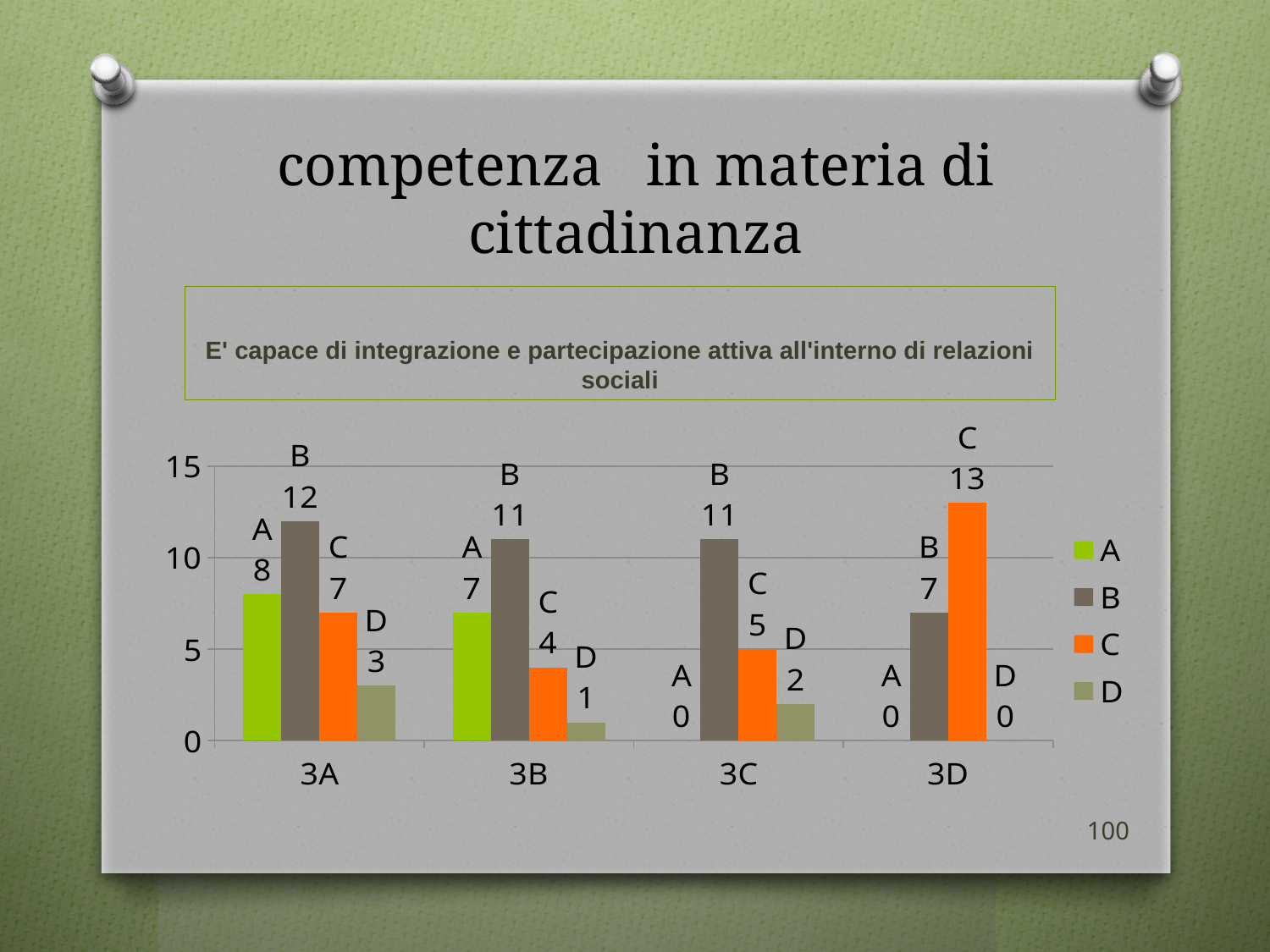
Which is larger for category 3C: series B or series C? B What is the value of series D for category 3B? 1 Which series has the lowest value for category 3A? D What kind of chart is shown on the slide? bar chart What is the difference between series B and series C for category 3B? 7 How many categories are shown on the x axis? 4 What colour represents series C in the legend? orange What is the value of series A for category 3C? 0 What is the value of series B for category 3A? 12 How many series does the legend list? 4 What is the value of series C for category 3D? 13 Which series has the highest value for category 3D? C